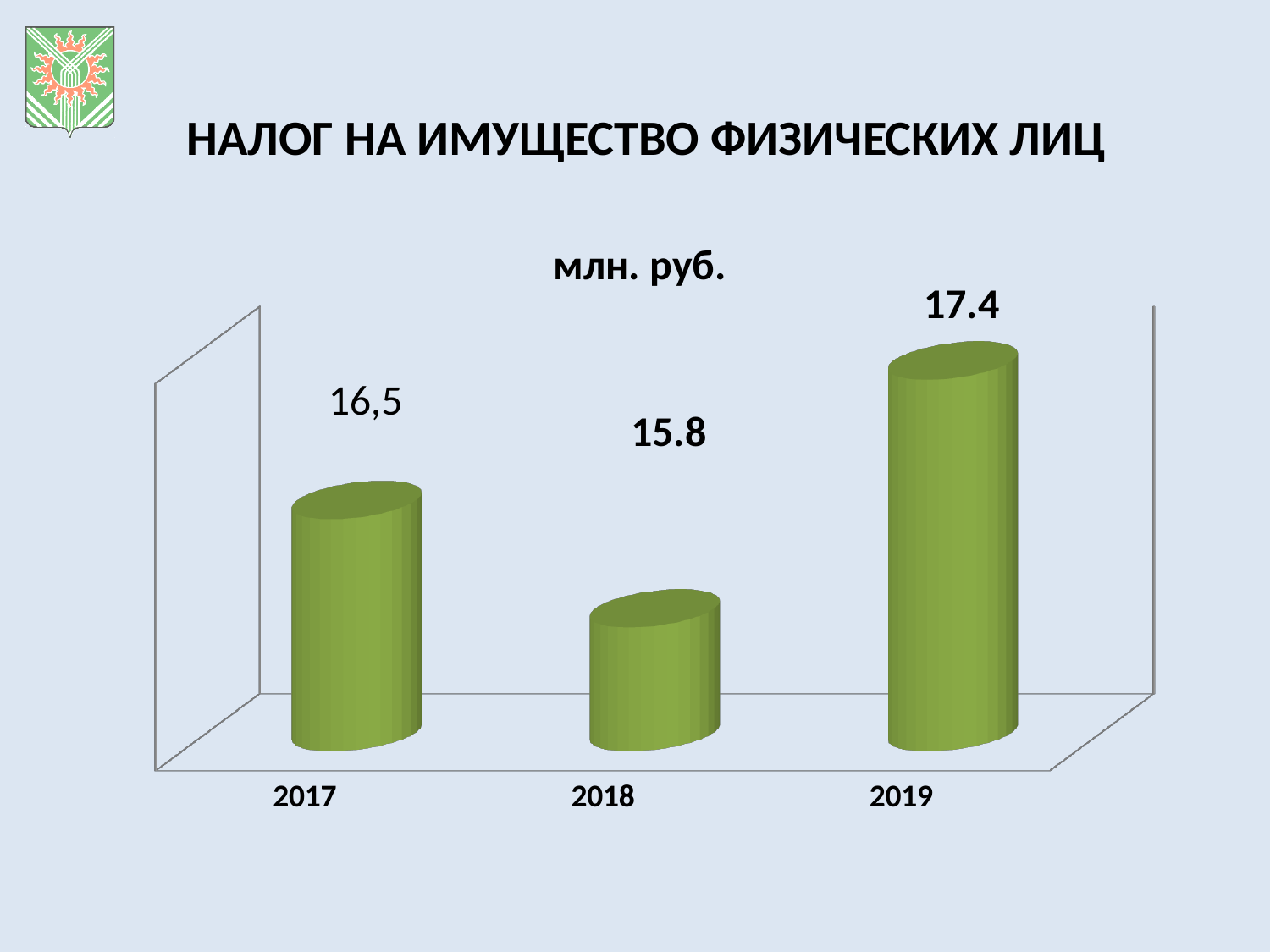
What is the difference between the values for 2019 and 2017? 0.9 What is the value for 2019? 17.4 Which year has the lowest value? 2018 Does the value rise or fall from 2017 to 2018? fall What kind of chart is shown on the slide? bar chart How many years are shown on the chart? 3 What is the value for 2018? 15.8 Which is larger, the value for 2017 or the value for 2018? 2017 What is the title of the chart? млн. руб. What is the difference between the values for 2019 and 2018? 1.6 What is the value for 2017? 16,5 Which year has the highest value? 2019